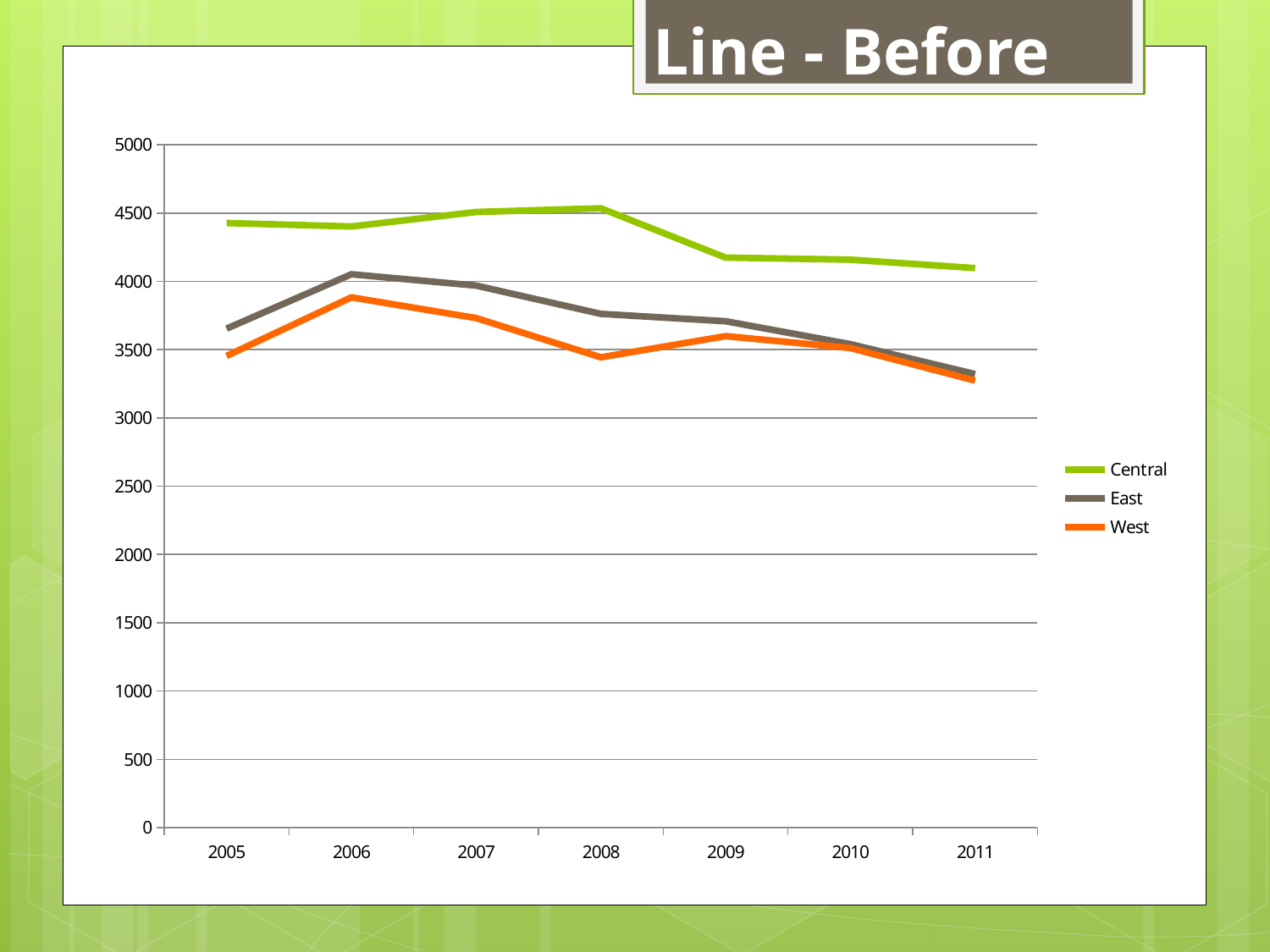
What kind of chart is shown on the slide? Line chart How many years are shown on the x axis? 7 What is the title of the slide? Line - Before How many series does the legend list? 3 What colour is the West line? Orange Which series has the highest value in 2008? Central In which year does the East series reach its highest value? 2006 Is the value for East in 2011 greater or less than 3500? less Which is larger in 2006, East or West? East Is the value for Central in 2009 greater or less than 4000? greater Does the Central series rise or fall from 2008 to 2011? Fall Which series has the lowest value in 2005? West